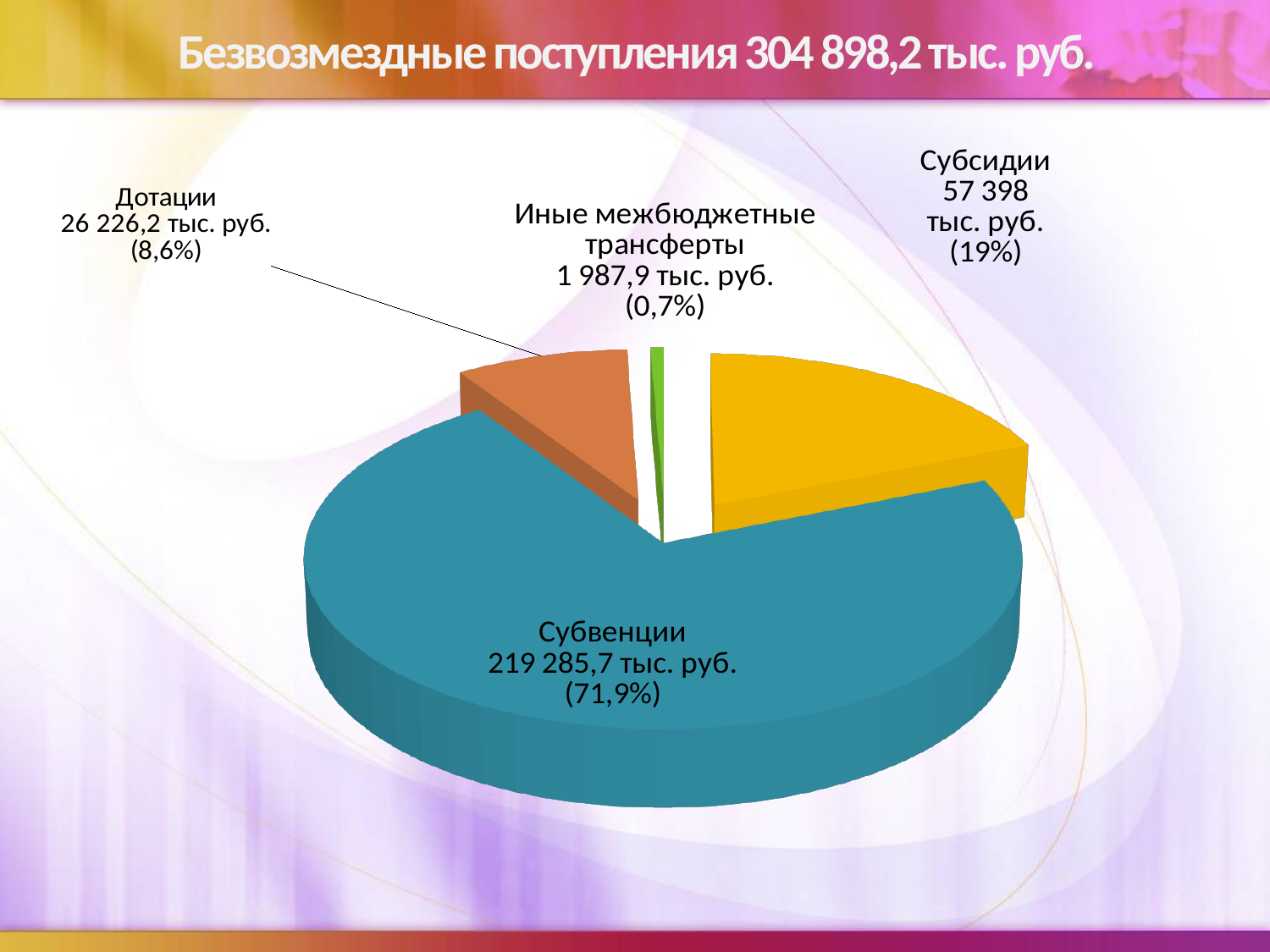
What is the value for Субвенции? 219 285,7 тыс. руб. What is the value for Дотации? 26 226,2 тыс. руб. What is the value for Субсидии? 57 398 тыс. руб. What is the difference between the values for Субсидии and Дотации? 31 171,8 тыс. руб. Which category has the largest slice of the pie? Субвенции How many categories are shown in the pie chart? 4 What is the value for Иные межбюджетные трансферты? 1 987,9 тыс. руб. What share of the pie does Субсидии represent? 19% What share of the pie does Дотации represent? 8,6% What kind of chart is shown on the slide? Pie chart Which category has the smallest slice of the pie? Иные межбюджетные трансферты Which is larger, the value for Субсидии or the value for Дотации? Субсидии